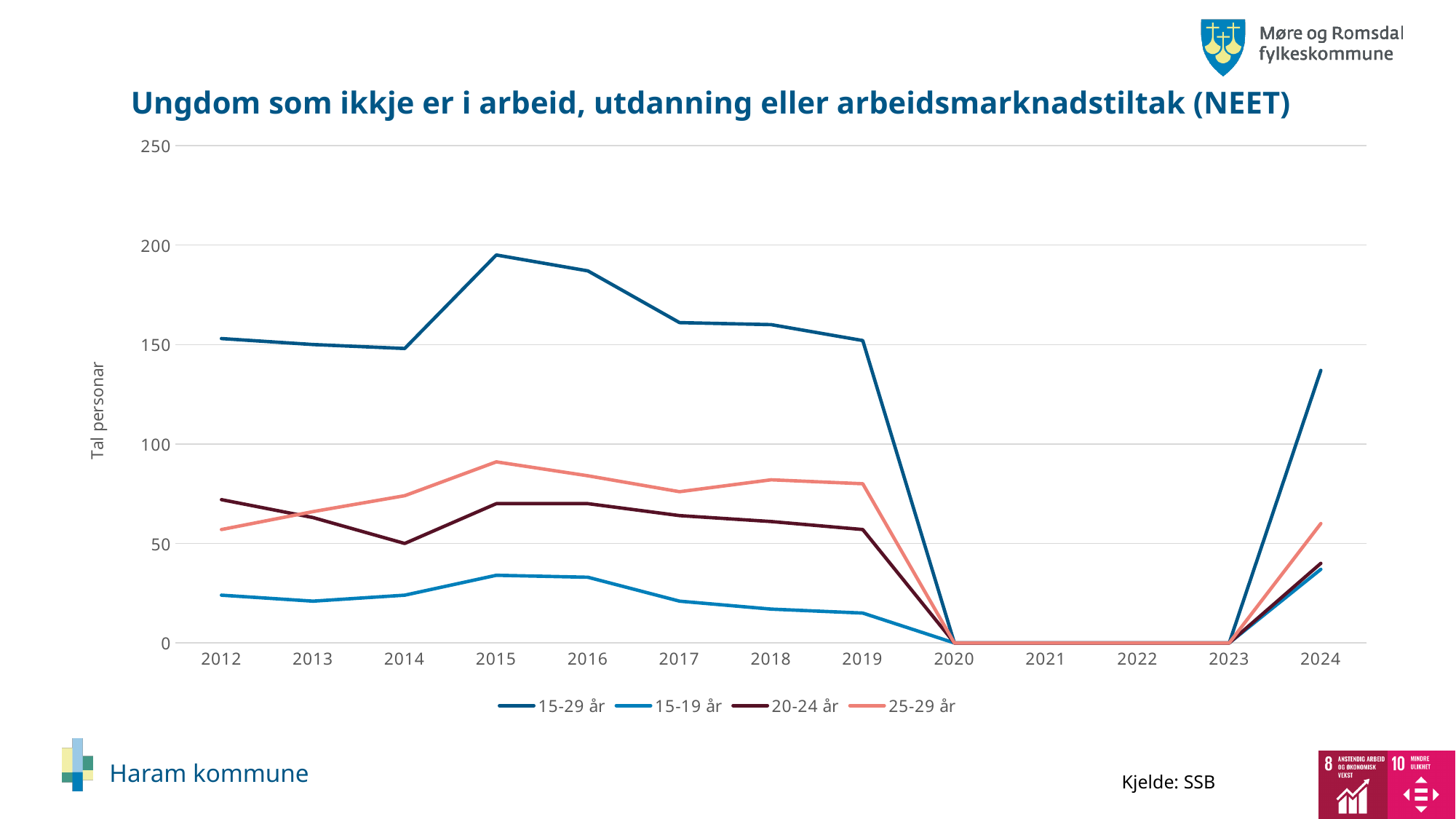
Is the value for 15-19 år in 2015 greater or less than 50? less What is the value for 15-29 år in 2021? 0 What kind of chart is shown on the slide? line chart Is the value for 15-29 år in 2024 greater or less than 100? greater Does the 15-29 år series rise or fall from 2015 to 2019? fall In which year does the 15-29 år series reach its highest value? 2015 In 2015, which is larger: 25-29 år or 20-24 år? 25-29 år What is the label on the y axis? Tal personar How many years are shown along the x axis? 13 Is the value for 15-29 år in 2015 greater or less than 150? greater How many series does the legend list? 4 In 2012, which is larger: 20-24 år or 25-29 år? 20-24 år